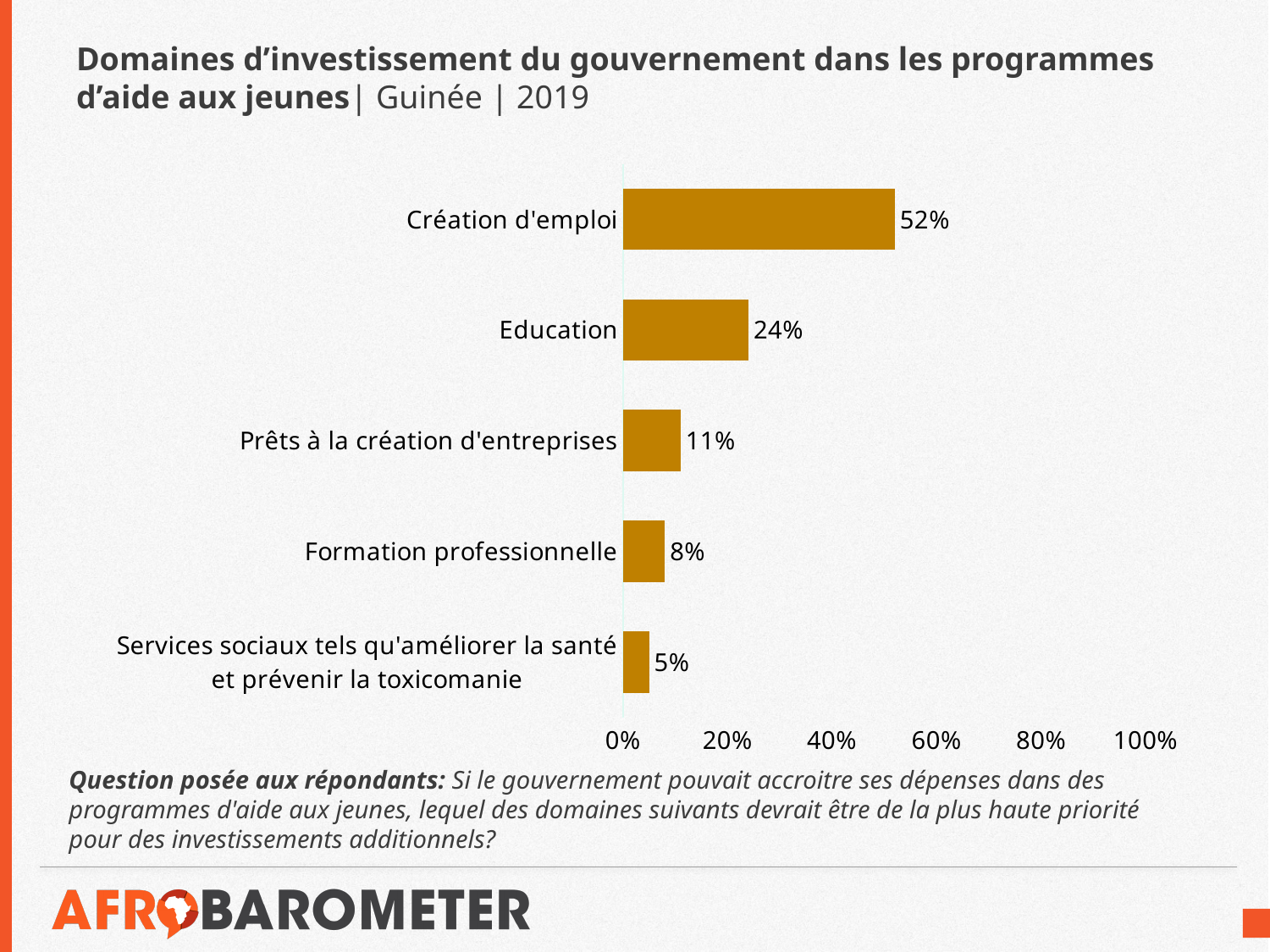
How many categories are shown in the chart? 5 Is the value for Création d'emploi greater or less than 40%? greater Which category has the lowest value? Services sociaux tels qu'améliorer la santé et prévenir la toxicomanie What is the value for Education? 24% What is the value for Prêts à la création d'entreprises? 11% What kind of chart is shown on the slide? Bar chart What is the value for Formation professionnelle? 8% What is the value for Création d'emploi? 52% Which is larger, the value for Prêts à la création d'entreprises or the value for Formation professionnelle? Prêts à la création d'entreprises What is the value for Services sociaux tels qu'améliorer la santé et prévenir la toxicomanie? 5% What is the difference between the values for Création d'emploi and Education? 28% Which category has the highest value? Création d'emploi